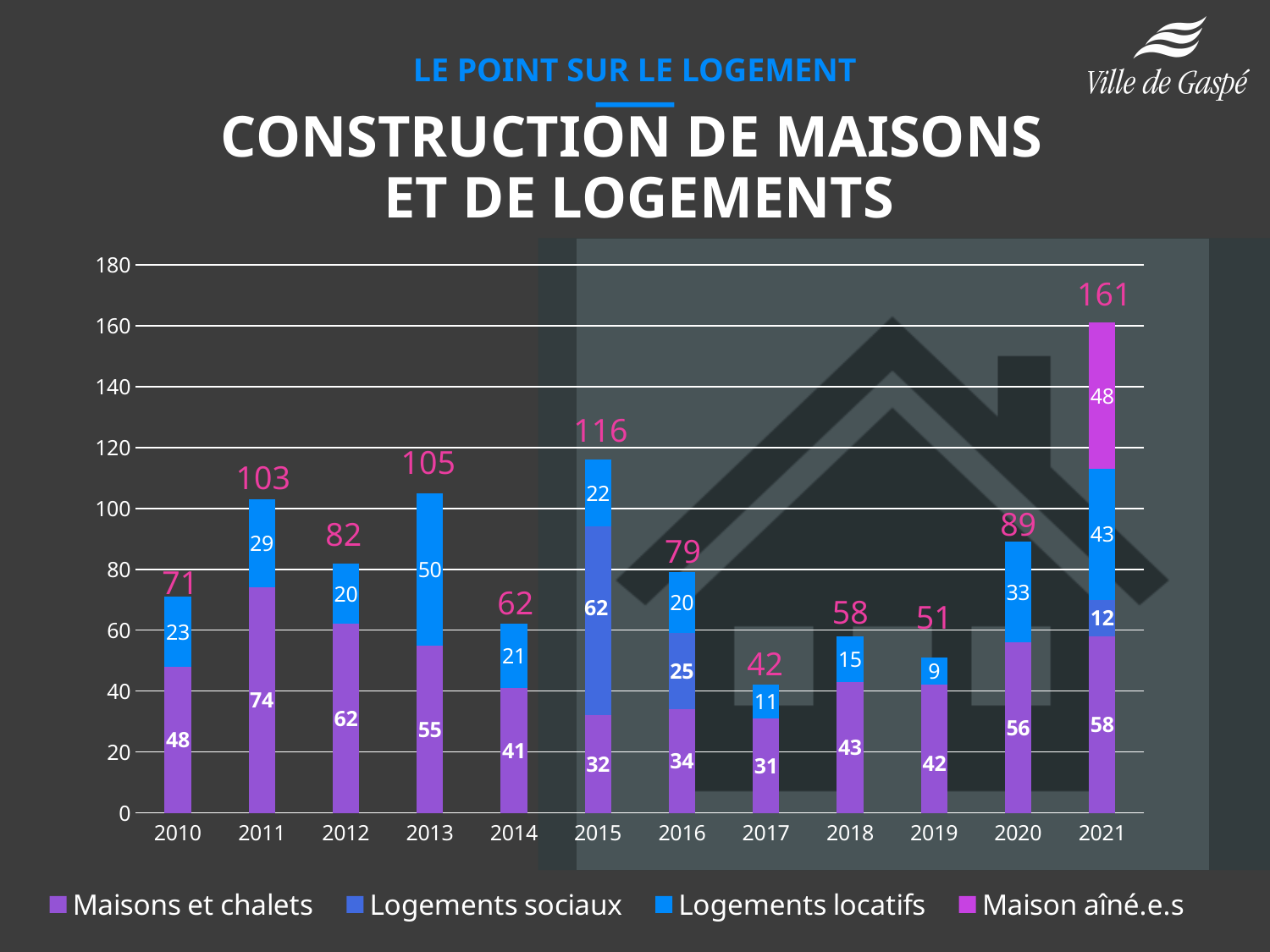
Which is larger, the total for 2012 or the total for 2020? 2020 How many series does the legend list? 4 What is the value for Maisons et chalets in 2011? 74 What is the difference between the totals for 2015 and 2016? 37 What type of chart is shown on the slide? stacked bar chart What is the value for Maison aîné.e.s in 2021? 48 What is the value for Logements locatifs in 2013? 50 Which year has the highest total? 2021 What is the value for Logements sociaux in 2015? 62 How many years are shown on the x axis? 12 What is the total of the stacked bar for 2021? 161 Which year has the lowest total? 2017